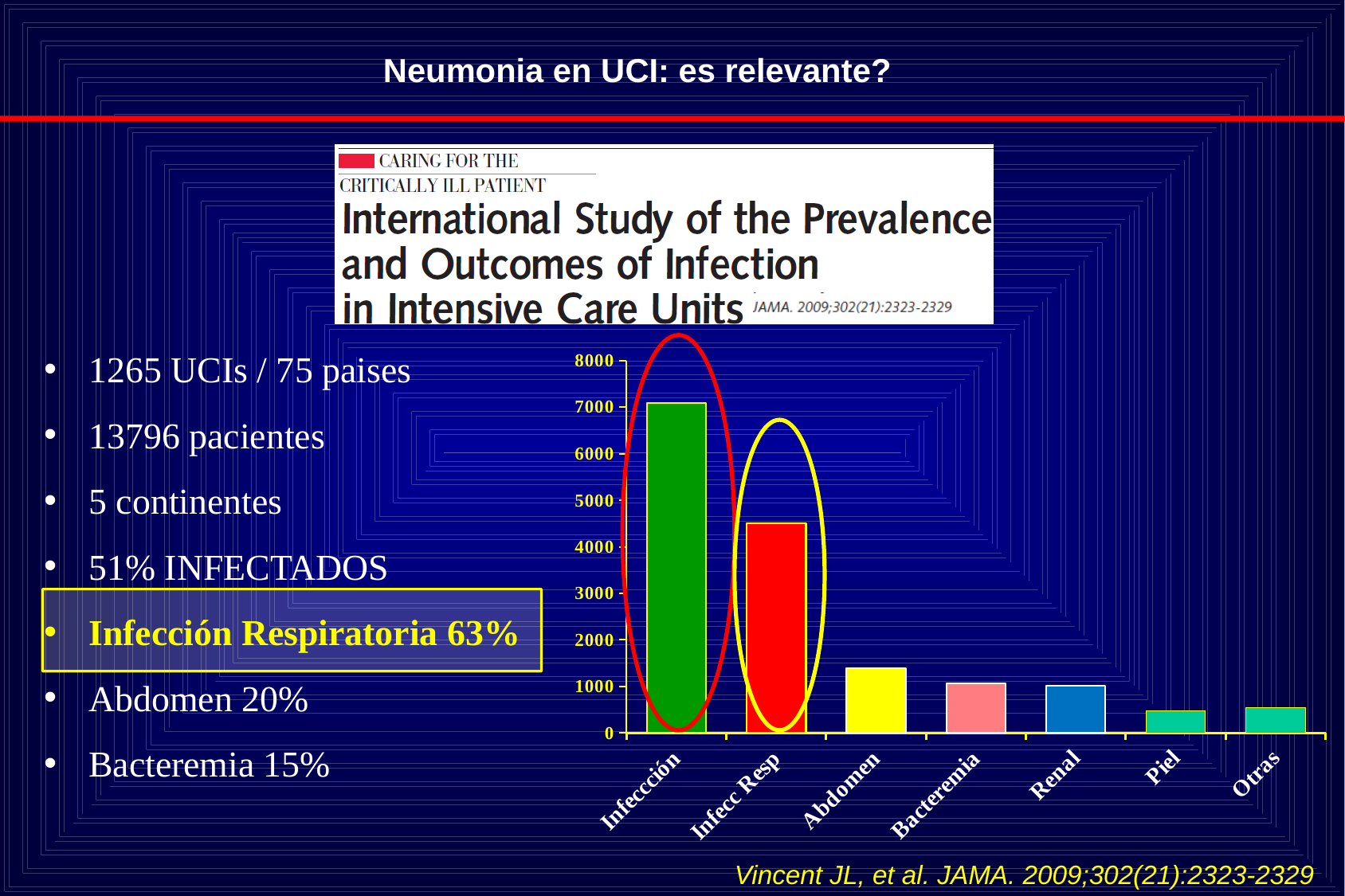
Is the value for Bacteremia greater or less than 2000? less Is the value for Infección greater or less than 6000? greater Which category has the highest bar in the chart? Infeccción Is the value for Piel greater or less than 1000? less What kind of chart is shown on the slide? bar chart Which is larger, the value for Abdomen or the value for Renal? Abdomen Which is larger, the value for Infección or the value for Infecc Resp? Infección What is the highest value shown on the y axis of the chart? 8000 How many categories are shown on the x axis of the chart? 7